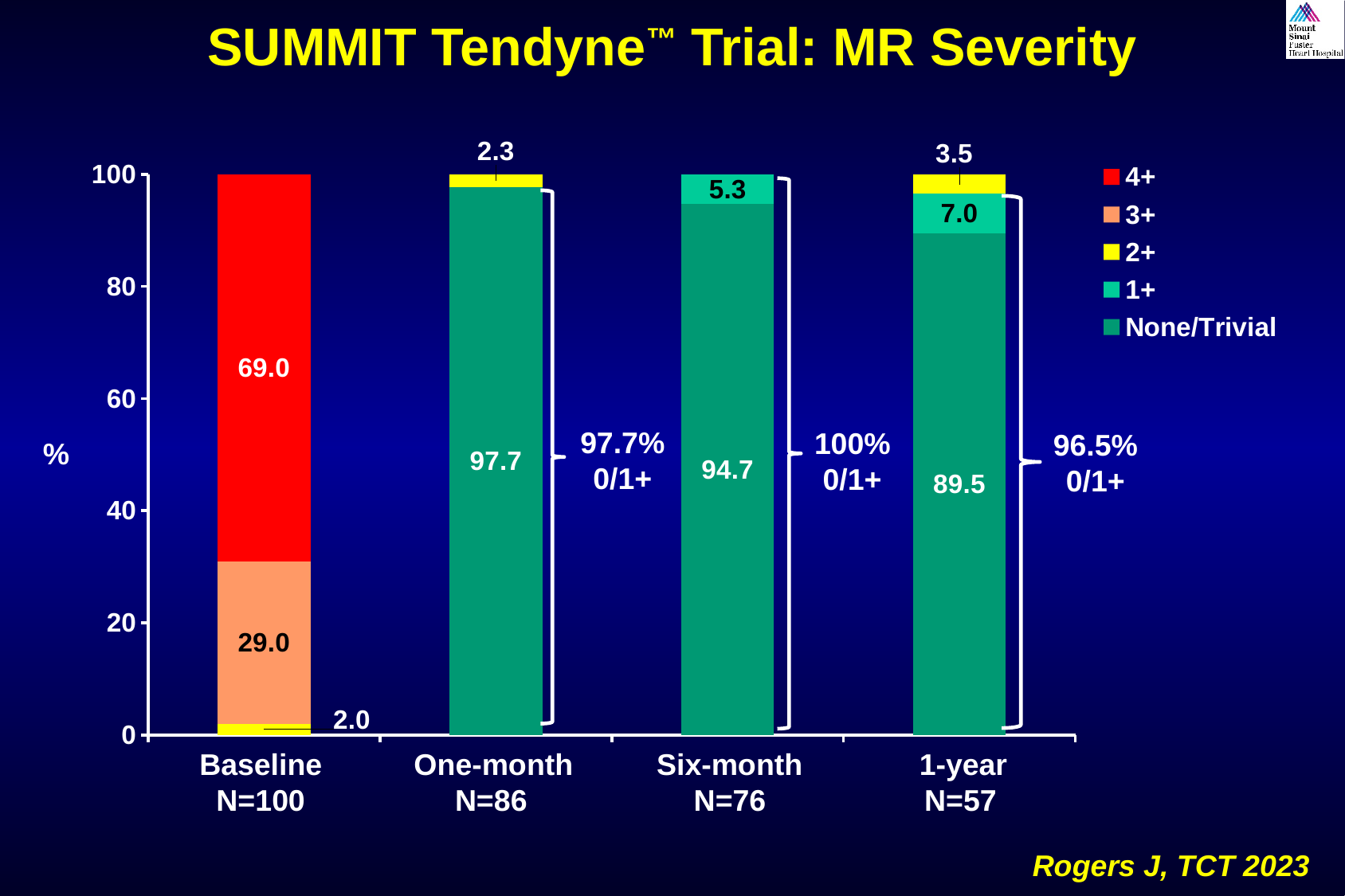
How many series does the legend list? 5 Which time point has the highest None/Trivial value? One-month What is the value for 4+ at Baseline? 69.0 What is the 1+ value at Six-month? 5.3 What is the difference between the None/Trivial values at One-month and 1-year? 8.2 What is the None/Trivial value at 1-year? 89.5 What is the sample size (N) shown for the Six-month category? N=76 What type of chart is shown on the slide? stacked bar chart What is the None/Trivial value at One-month? 97.7 How many time-point categories are shown on the x axis? 4 Is the 1+ value at 1-year larger or smaller than the 1+ value at Six-month? larger What is the value for 3+ at Baseline? 29.0